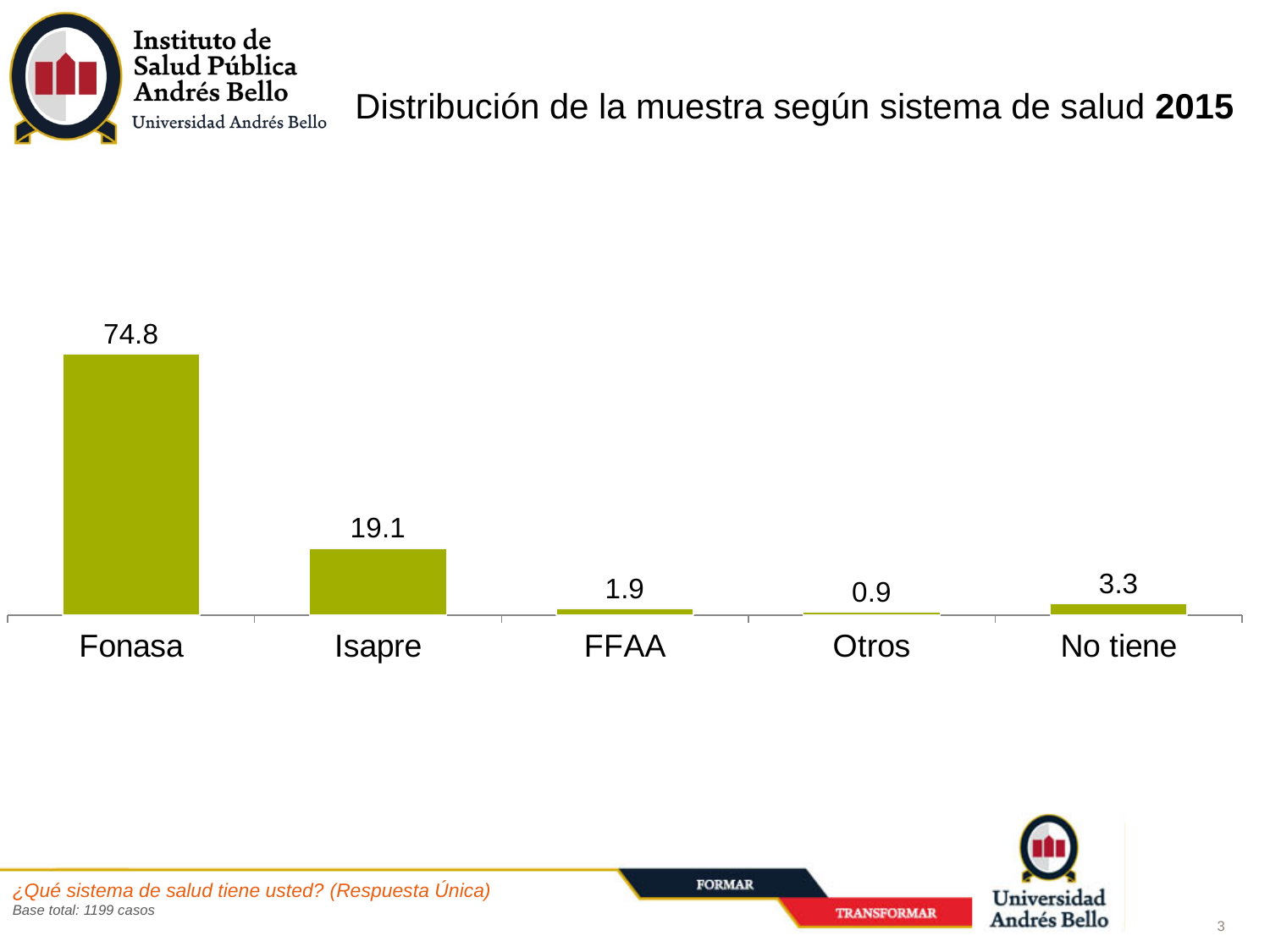
What is the value for Isapre? 19.1 What is the value for Fonasa? 74.8 What is the difference between the values for Fonasa and Isapre? 55.7 What is the title of the chart? Distribución de la muestra según sistema de salud 2015 What is the value for Otros? 0.9 What is the value for No tiene? 3.3 Which is larger, the value for No tiene or the value for FFAA? No tiene How many categories are shown on the x axis? 5 What kind of chart is shown on the slide? Bar chart Which category has the highest value? Fonasa What is the value for FFAA? 1.9 Which category has the lowest value? Otros